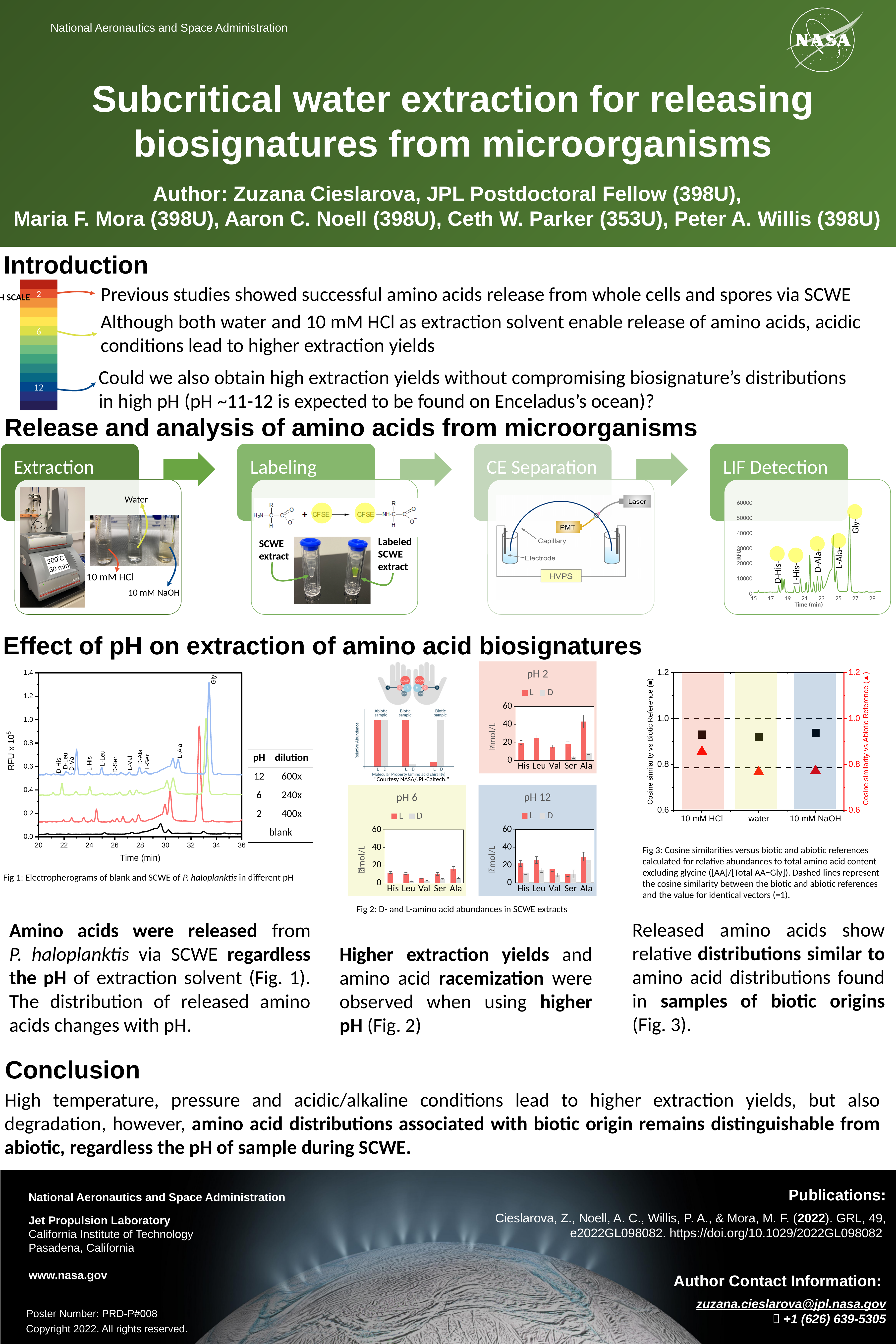
In the Fig 2 pH 2 chart, how many series does the legend list? 2 In the Fig 2 pH 12 chart, is the L value for Ser greater or less than 20 µmol/L? less In Fig 1, which labeled peak is the tallest in the electropherograms? Gly In Fig 3, which solvent has the highest cosine similarity vs abiotic reference (red triangles)? 10 mM HCl In the Fig 2 pH 2 chart, is the L value for Ala greater or less than 20 µmol/L? greater In the table next to Fig 1, what dilution is listed for pH 6? 240x In Fig 2, what kind of chart is used to show the D- and L-amino acid abundances at pH 2? bar chart In Fig 3, is the cosine similarity vs biotic reference (black square) for water greater or less than 0.8? greater In the Fig 2 pH 12 chart, which is larger for Ala, the L value or the D value? L In Fig 3, how many extraction solvents are shown on the x axis? 3 In the Fig 2 pH 2 chart, how many amino acid categories are shown on the x axis? 5 In the Fig 2 pH 2 chart, which amino acid has the highest L value? Ala